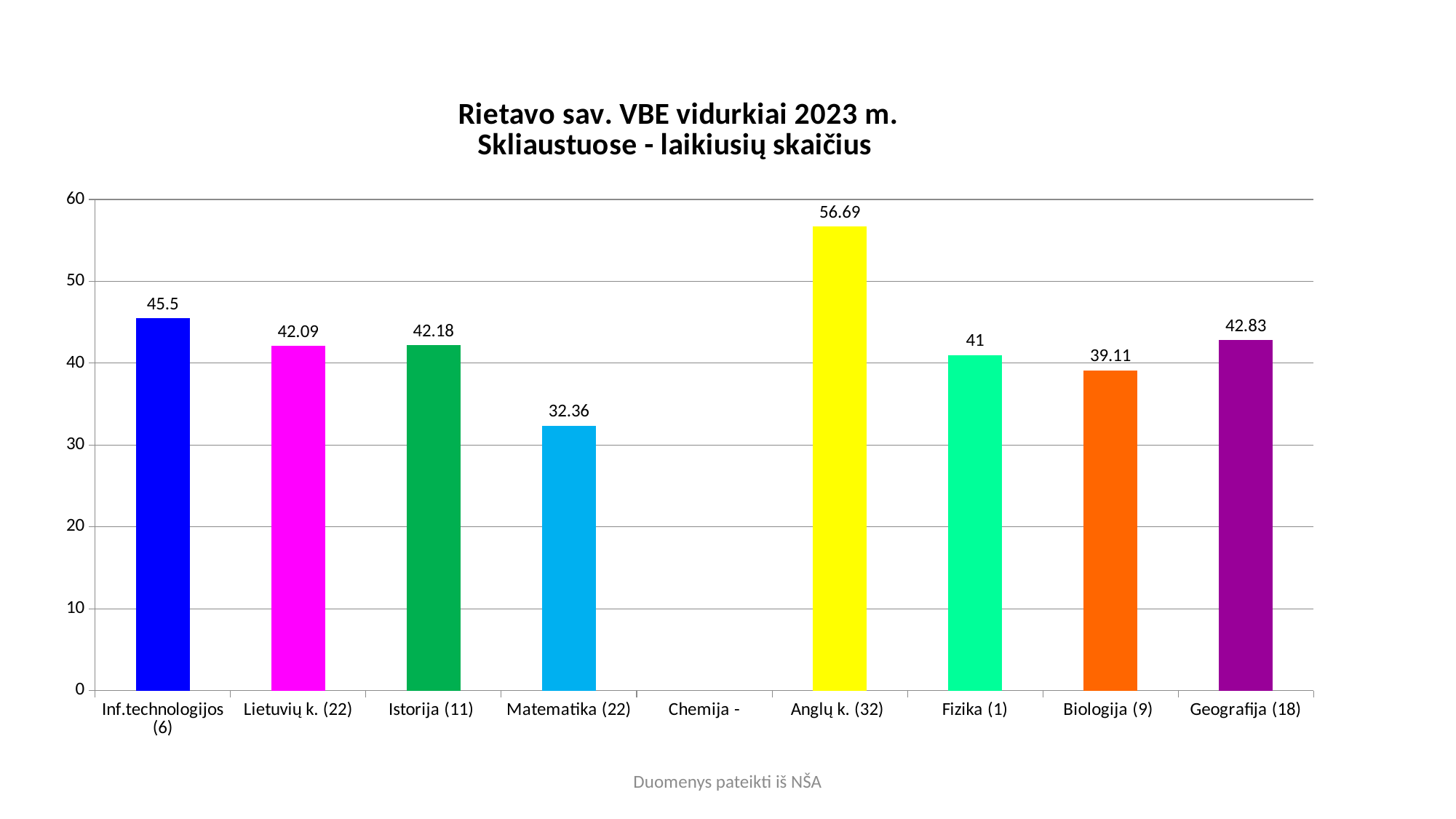
Which category with a plotted bar has the lowest value? Matematika (22) What is the value for Geografija (18)? 42.83 Is the value for Matematika (22) greater or less than 40? less Which category has the highest value? Anglų k. (32) What kind of chart is shown on the slide? Bar chart What is the difference between the values for Anglų k. (32) and Matematika (22)? 24.33 How many bars are plotted on the chart? 8 What is the value for Matematika (22)? 32.36 What is the difference between the values for Inf.technologijos (6) and Lietuvių k. (22)? 3.41 Which is larger, the value for Inf.technologijos (6) or the value for Biologija (9)? Inf.technologijos (6) What is the value for Fizika (1)? 41 What is the value for Anglų k. (32)? 56.69